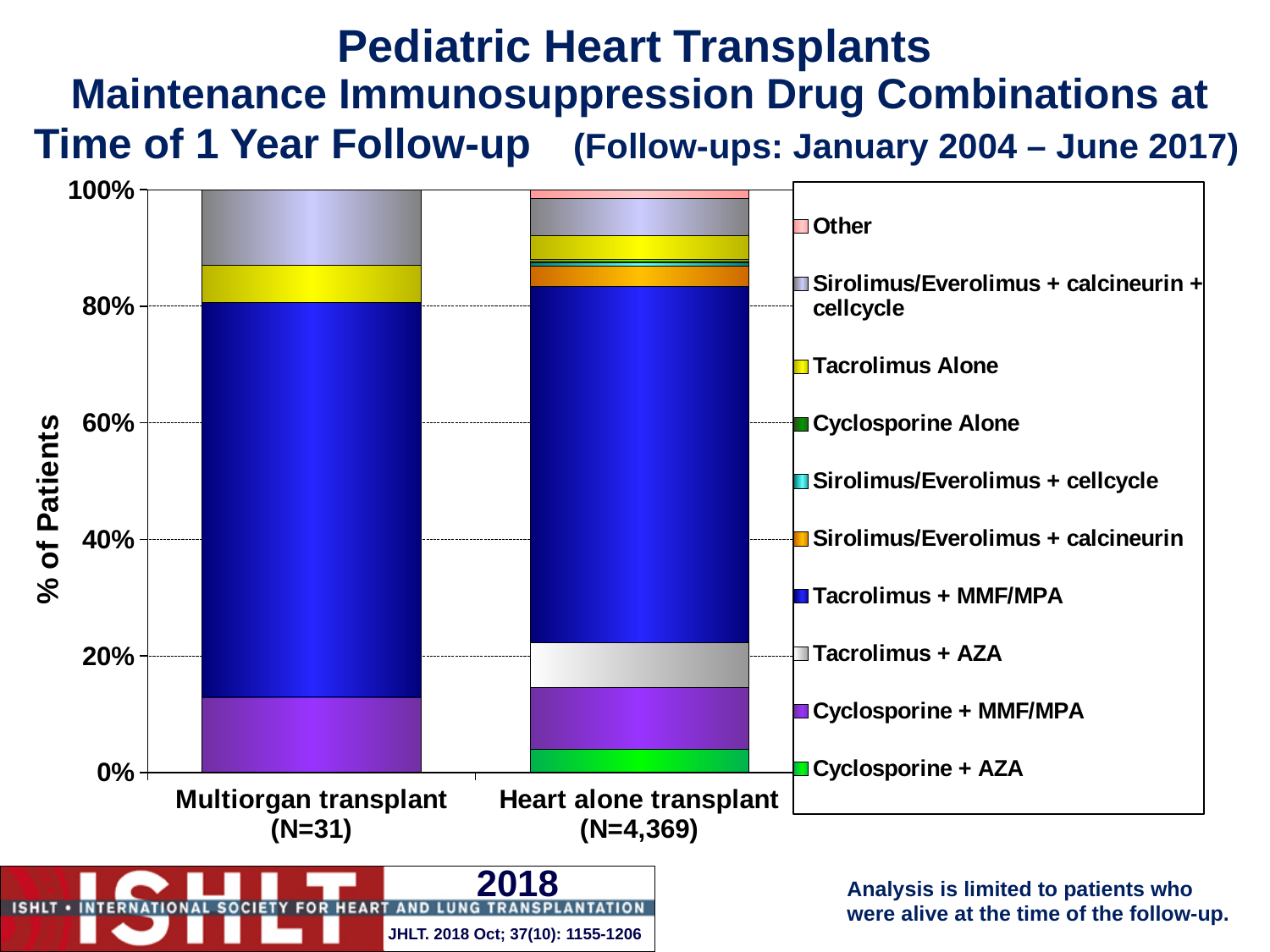
Is the share of Tacrolimus + AZA in the Heart alone transplant bar greater or less than 20%? less What kind of chart is shown on the slide? stacked bar chart What is the label of the y axis? % of Patients Which group has the larger share of Cyclosporine + AZA, Multiorgan transplant or Heart alone transplant? Heart alone transplant Is the share of Cyclosporine + MMF/MPA in the Multiorgan transplant bar greater or less than 20%? less How many transplant categories are plotted on the x axis? 2 Which drug combination makes up the largest segment of the Multiorgan transplant bar? Tacrolimus + MMF/MPA Is the share of Tacrolimus + MMF/MPA in the Multiorgan transplant bar greater or less than 60%? greater What is the N shown for the Heart alone transplant group? N=4,369 How many drug combination series does the legend list? 10 What does each stacked bar total on the % of Patients axis? 100% Which drug combination makes up the largest segment of the Heart alone transplant bar? Tacrolimus + MMF/MPA